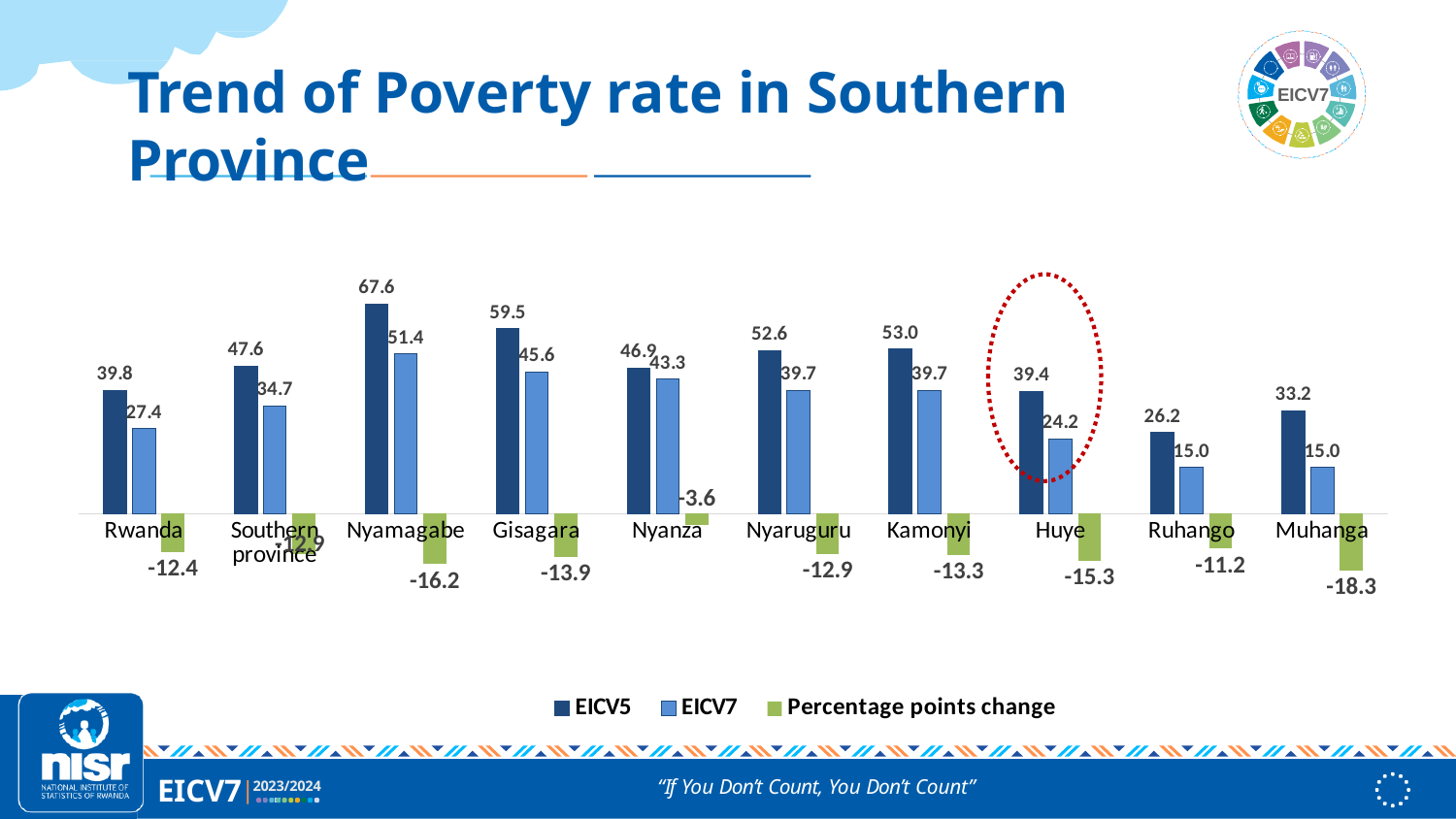
Which category has the highest EICV5 poverty rate? Nyamagabe Which has a higher EICV7 poverty rate, Nyamagabe or Gisagara? Nyamagabe What is the difference between the EICV5 and EICV7 values for Gisagara? 13.9 What is the EICV7 poverty rate for Huye? 24.2 How many categories are shown on the x axis? 10 Which category has the smallest percentage points change (closest to zero)? Nyanza What is the EICV5 poverty rate for Nyamagabe? 67.6 Which category has the lowest EICV5 poverty rate? Ruhango How many series does the legend list? 3 What is the percentage points change shown for Muhanga? -18.3 What is the EICV7 value for Nyanza? 43.3 What kind of chart is shown on the slide? Bar chart